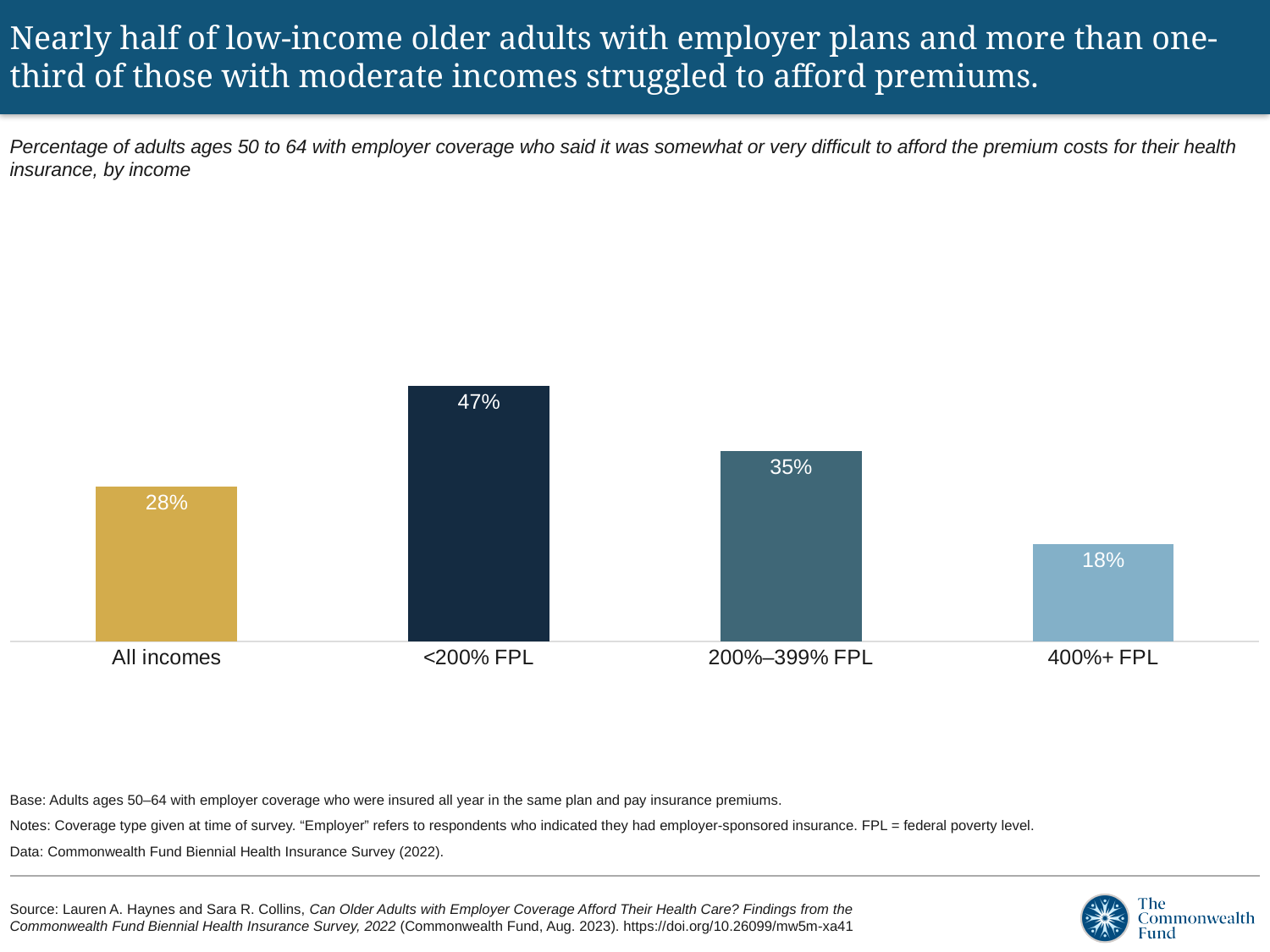
Which is larger, the value for 200%–399% FPL or the value for All incomes? 200%–399% FPL How many income categories are shown in the chart? 4 Which income category has the highest percentage? <200% FPL What kind of chart is shown on the slide? Bar chart Do the values rise or fall from <200% FPL to 400%+ FPL? Fall What is the difference between the 200%–399% FPL value and the All incomes value? 7 percentage points What is the difference in percentage points between <200% FPL and 400%+ FPL? 29 percentage points What is the value for the All incomes bar? 28% What is the value for the 400%+ FPL category? 18% What percentage is shown for the <200% FPL category? 47% Which income category has the lowest percentage? 400%+ FPL What percentage is shown for 200%–399% FPL? 35%